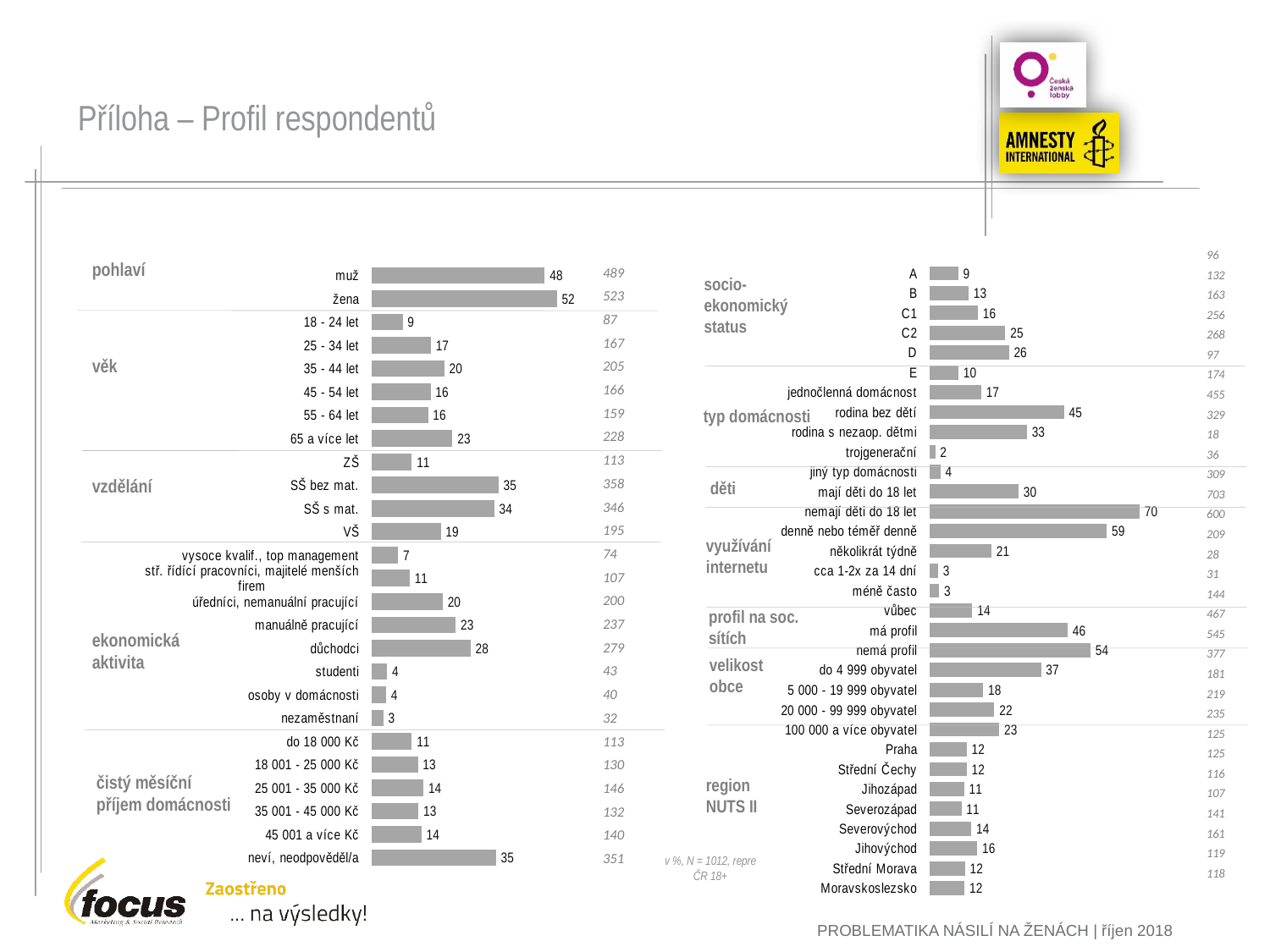
On the right chart, which region under "region NUTS II" has the highest value? Jihovýchod On the left chart, which age group (věk) has the lowest value? 18 - 24 let On the left chart, what is the value for "žena"? 52 On the left chart, what is the difference between "SŠ bez mat." and "VŠ"? 16 On the right chart, which category under "typ domácnosti" has the highest value? rodina bez dětí On the left chart, what is the value for "65 a více let"? 23 On the left chart, which is larger: "manuálně pracující" or "úředníci, nemanuální pracující"? manuálně pracující On the left chart, which category under "ekonomická aktivita" has the highest value? důchodci On the right chart, what is the value for "nemají děti do 18 let"? 70 What type of chart is used on the slide? bar chart On the right chart, what is the difference between "má profil" and "nemá profil"? 8 On the right chart, how many categories are listed under "socio-ekonomický status"? 6